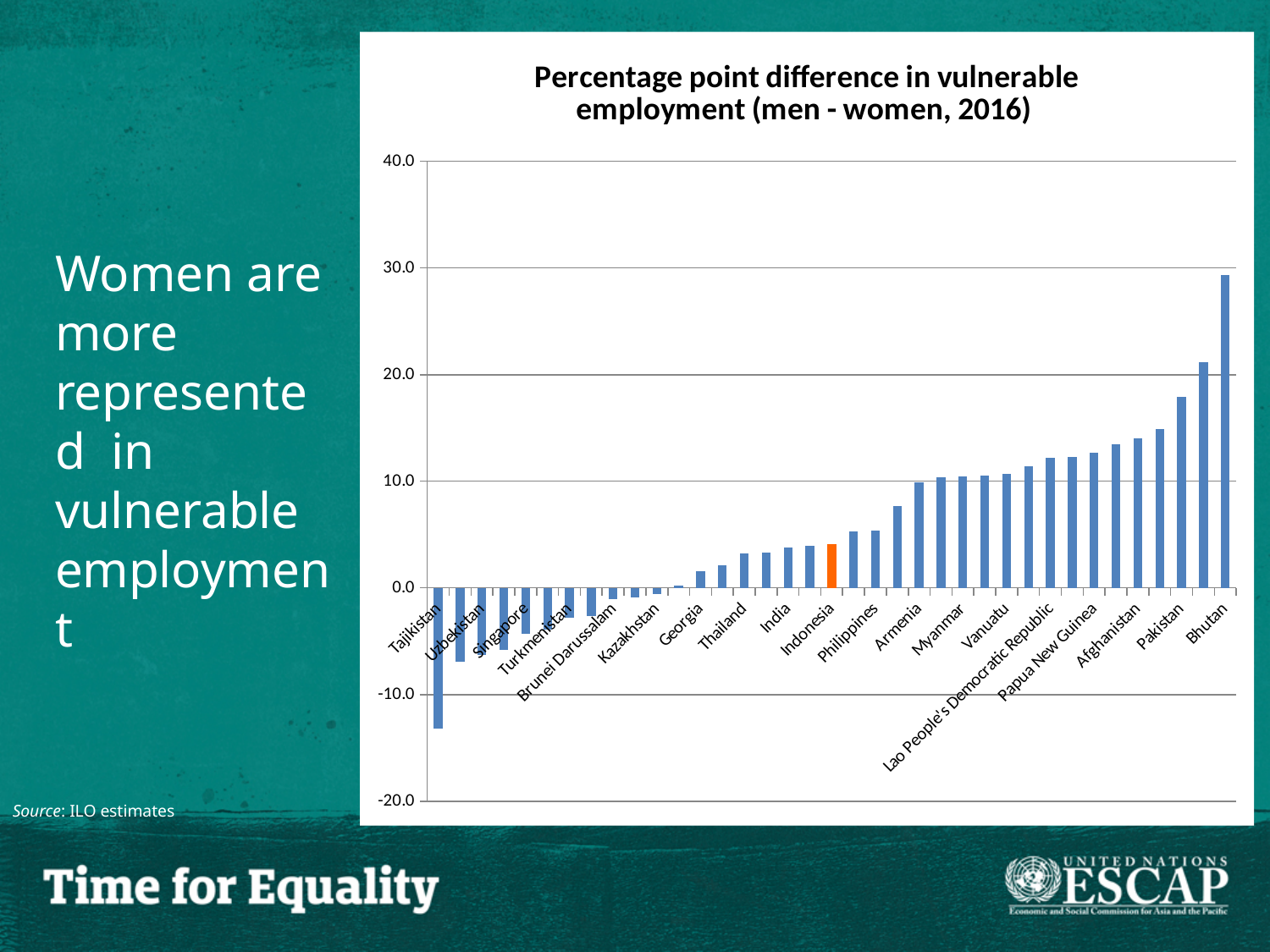
What is the title of the chart? Percentage point difference in vulnerable employment (men - women, 2016) Is the value for Afghanistan greater or less than 10.0? greater Is the value for Philippines greater or less than 10.0? less Which country has the lowest value in the chart? Tajikistan Which country's bar is highlighted in orange? Indonesia Which has the larger value, Afghanistan or Philippines? Afghanistan Is the value for Uzbekistan greater or less than 0.0? less Do the values generally rise or fall moving from left to right along the x axis? rise Which country has the highest value in the chart? Bhutan What kind of chart is shown on the slide? Bar chart